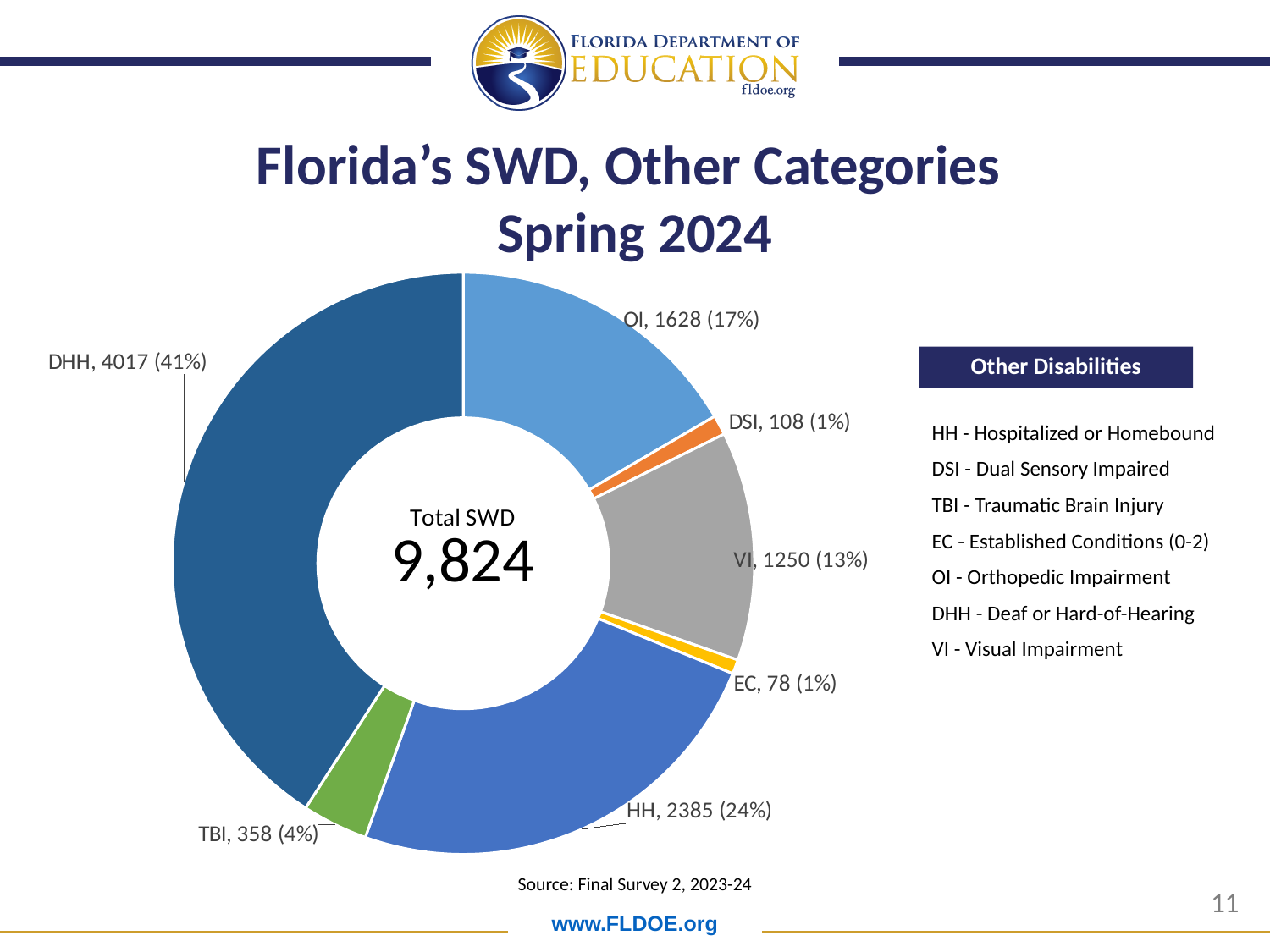
What is the value for HH? 2385 What kind of chart is shown on the slide? Doughnut chart What is the value for DHH? 4017 What is the difference between the values for OI and VI? 378 How many categories are shown in the chart? 7 What is the difference between the values for DHH and HH? 1632 What is the value for VI? 1250 Which is larger, the value for TBI or the value for DSI? TBI Which category has the lowest value? EC Which category has the highest value? DHH What share of the total does OI represent? 17% What is the total SWD shown in the centre of the chart? 9,824